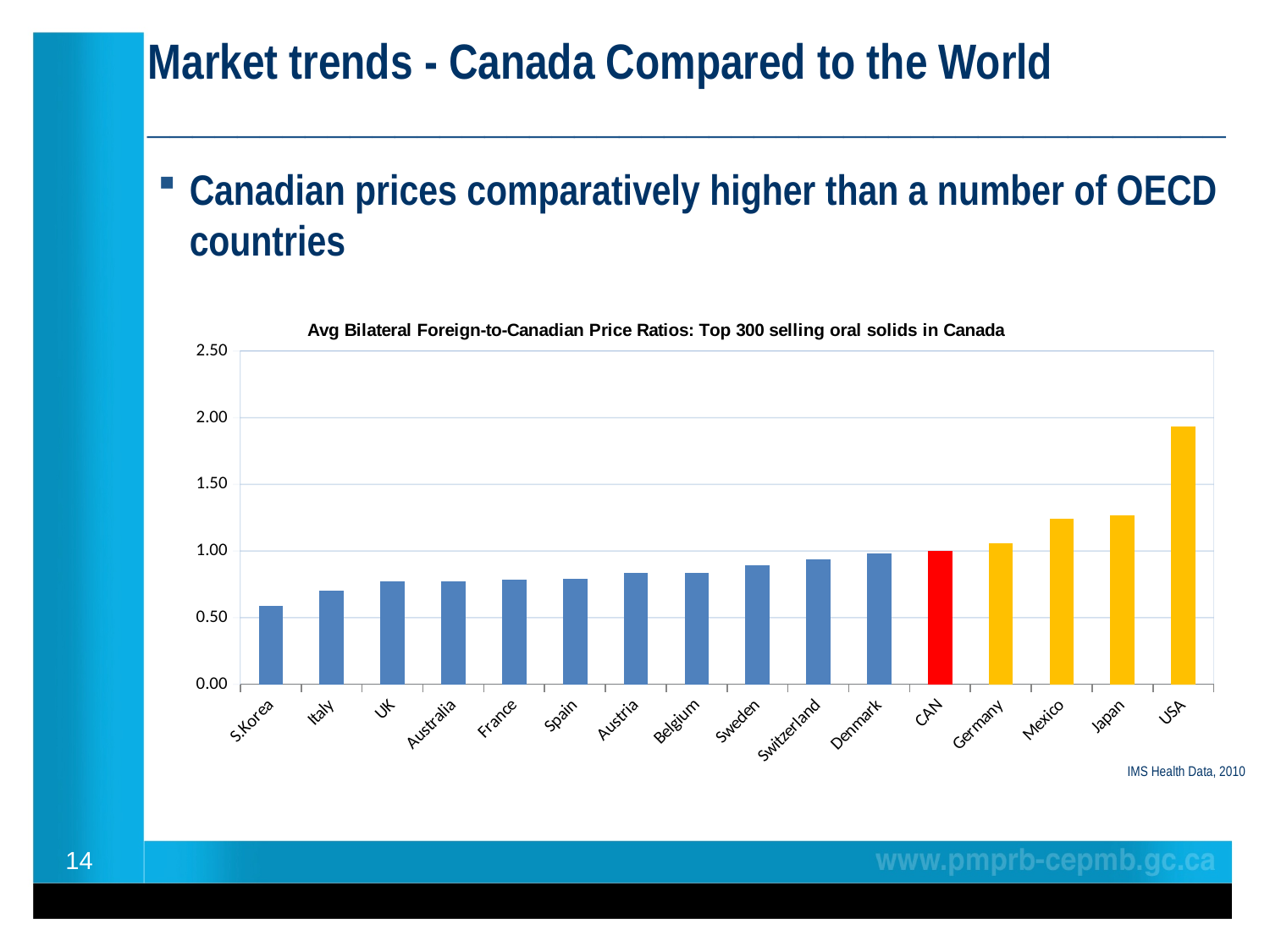
Is the value for Italy greater or less than 1.00? less Which country has the highest average bilateral foreign-to-Canadian price ratio? USA Which country has the lowest average bilateral foreign-to-Canadian price ratio? S.Korea What kind of chart is shown on the slide? bar chart Do the values generally rise or fall moving from left to right along the x axis? rise What colour is the bar for CAN? red Is the value for Mexico greater or less than 1.00? greater Is the value for Japan greater or less than 1.50? less How many countries are shown on the x axis of the chart? 16 Which has the larger price ratio, USA or Japan? USA